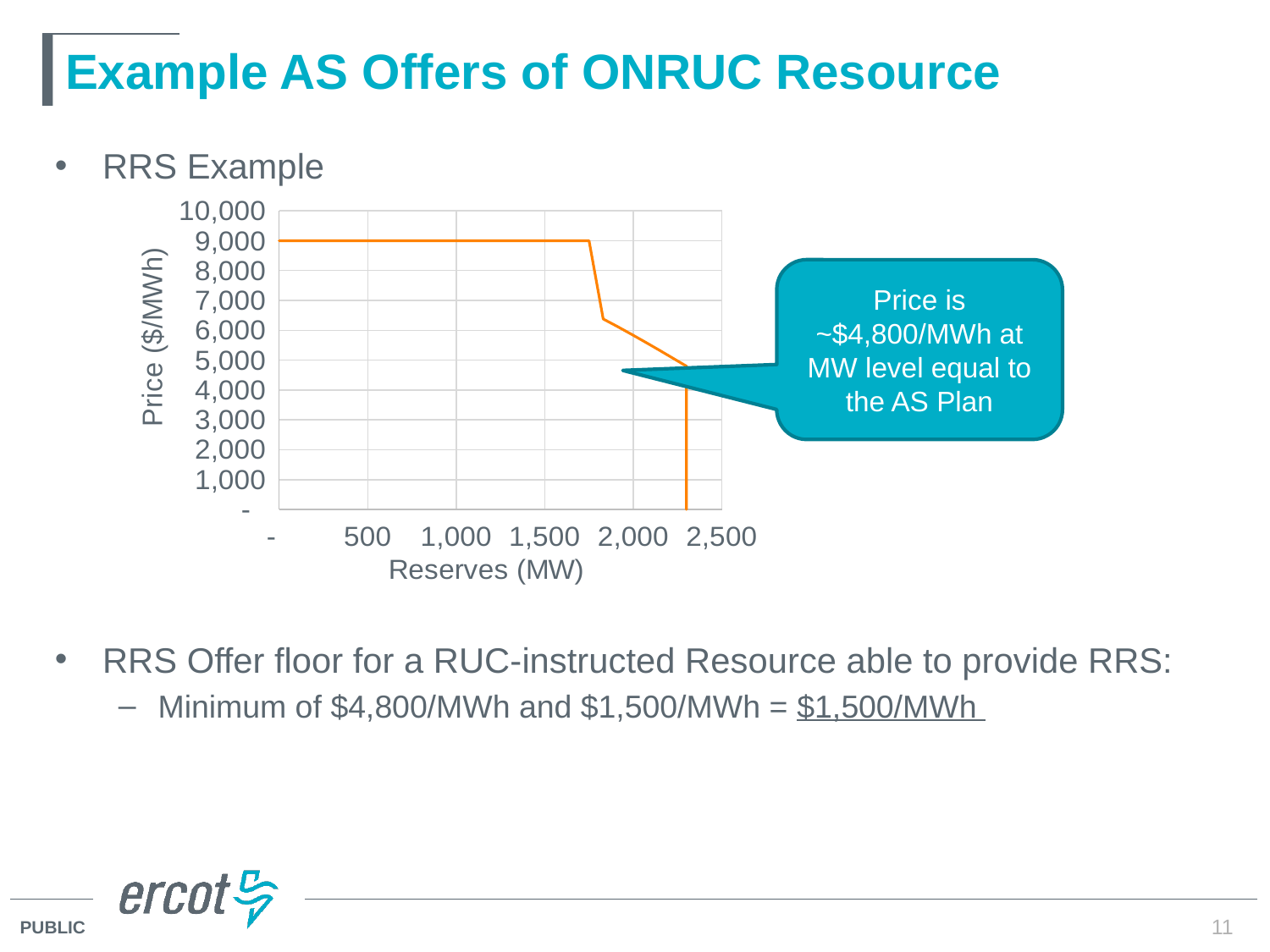
What is the title of the horizontal axis of the chart? Reserves (MW) What kind of chart is shown on the slide? line chart Does the price rise or fall as reserves increase along the x axis? fall What price does the line show at 1,000 MW of reserves? 9,000 What is the highest price level the line reaches on the chart? 9,000 What price does the line show at 500 MW of reserves? 9,000 Which is higher, the price at 1,000 MW or the price at 2,000 MW of reserves? 1,000 MW Is the price at 1,500 MW of reserves greater or less than 8,000? greater Is the price at 2,000 MW of reserves greater or less than 7,000? less Is the price at 2,000 MW of reserves greater or less than 4,000? greater What is the title of the vertical axis of the chart? Price ($/MWh) What is the highest tick value shown on the vertical axis? 10,000